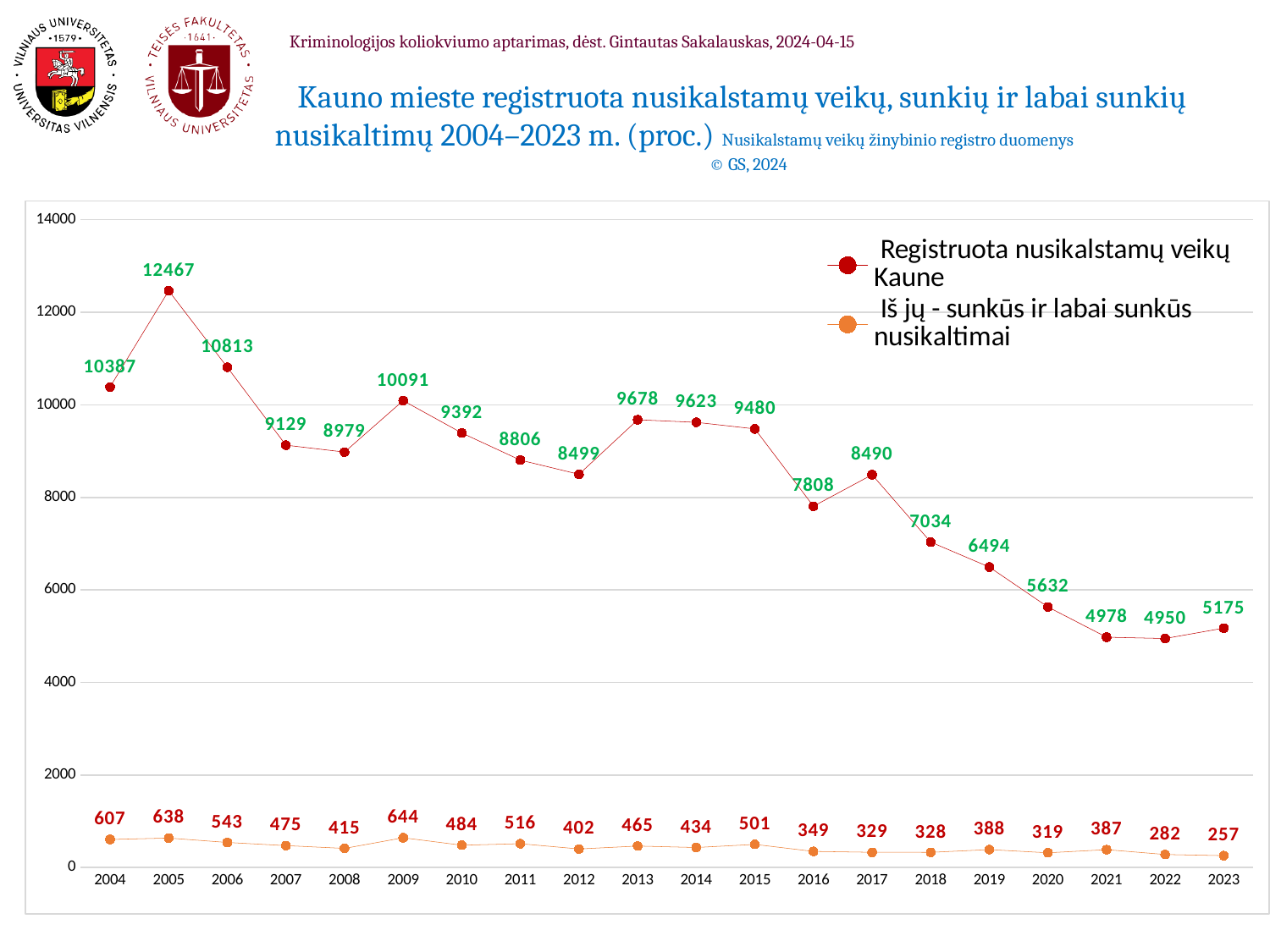
In which year is 'Registruota nusikalstamų veikų Kaune' lowest? 2022 Which is larger for 'Registruota nusikalstamų veikų Kaune': 2016 or 2017? 2017 What is the difference between the 'Registruota nusikalstamų veikų Kaune' values for 2005 and 2004? 2080 What is the value for 'Iš jų - sunkūs ir labai sunkūs nusikaltimai' in 2023? 257 Overall, does 'Registruota nusikalstamų veikų Kaune' rise or fall from 2004 to 2023? fall How many years are plotted along the x axis? 20 How many series does the legend list? 2 What is the value for 'Registruota nusikalstamų veikų Kaune' in 2005? 12467 What type of chart is shown on the slide? line chart In which year is 'Iš jų - sunkūs ir labai sunkūs nusikaltimai' highest? 2009 In which year is 'Registruota nusikalstamų veikų Kaune' highest? 2005 Is the value for 'Registruota nusikalstamų veikų Kaune' in 2020 greater or less than 6000? less